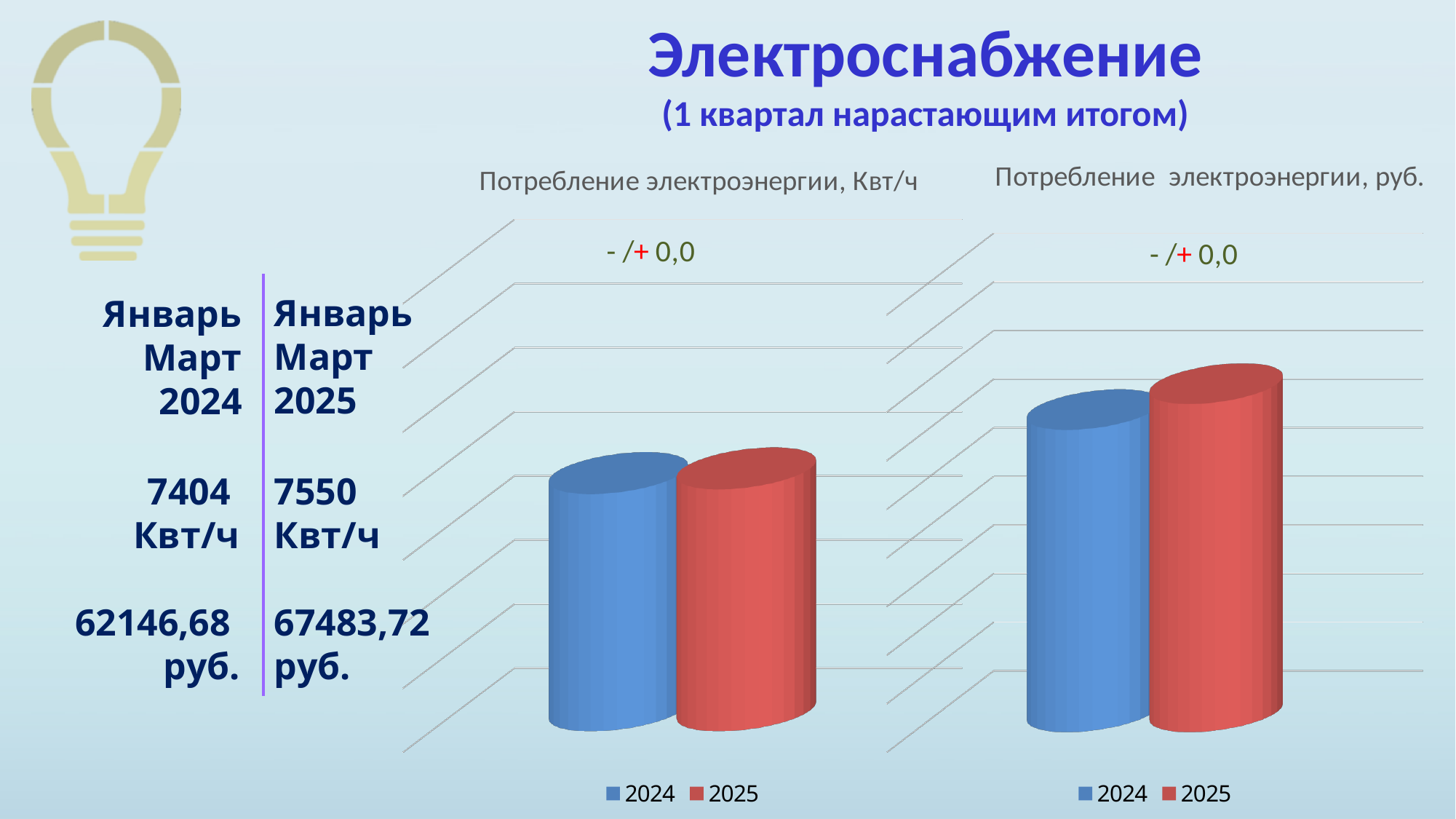
What kind of chart is the left chart titled "Потребление электроэнергии, Квт/ч"? bar chart For the right chart (руб.), by how much does the 2025 value exceed the 2024 value, using the figures printed on the slide? 5337,04 руб. In the left chart (Потребление электроэнергии, Квт/ч), which series has the taller bar, 2024 or 2025? 2025 According to the slide, what is the electricity cost in руб. for January–March 2025 shown in the right chart? 67483,72 руб. How many series does the legend of the left chart (Квт/ч) list? 2 According to the slide, what is the electricity consumption in Квт/ч for January–March 2025 shown in the left chart? 7550 Квт/ч According to the slide, what is the electricity cost in руб. for January–March 2024 shown in the right chart? 62146,68 руб. According to the slide, what is the electricity consumption in Квт/ч for January–March 2024 shown in the left chart? 7404 Квт/ч For the left chart (Квт/ч), by how much does the 2025 value exceed the 2024 value, using the figures printed on the slide? 146 Квт/ч In the right chart (Потребление электроэнергии, руб.), which series has the taller bar, 2024 or 2025? 2025 In the left chart (Квт/ч), what colour is the bar for 2025? red What are the two legend entries of the right chart (руб.)? 2024, 2025